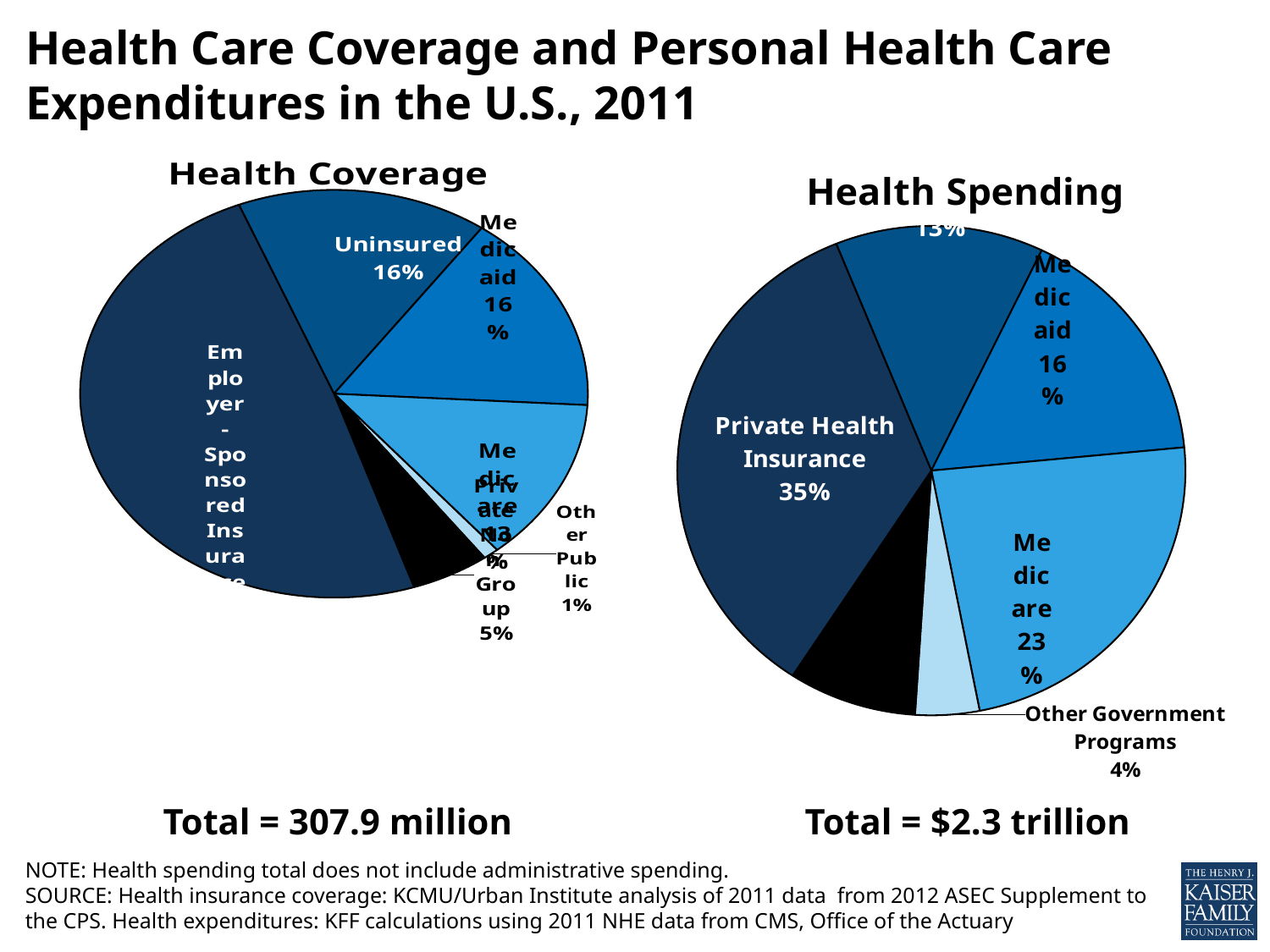
In the Health Spending chart, which is larger, Medicare or Medicaid? Medicare In the Health Spending chart, what share is Other Government Programs? 4% In the Health Coverage chart, what share is covered by Medicaid? 16% In the Health Coverage chart, which labeled category has the smallest slice? Other Public In the Health Coverage chart, what share of the population is Uninsured? 16% In the Health Coverage chart, which category has the largest slice? Employer-Sponsored Insurance In the Health Spending chart, what share is Medicare? 23% What type of chart is used for Health Spending? Pie chart In the Health Spending chart, what is the difference in percentage points between Medicare and Medicaid? 7 percentage points What total is shown beneath the Health Spending chart? Total = $2.3 trillion In the Health Spending chart, what share is Private Health Insurance? 35% In the Health Coverage chart, what share is Other Public? 1%